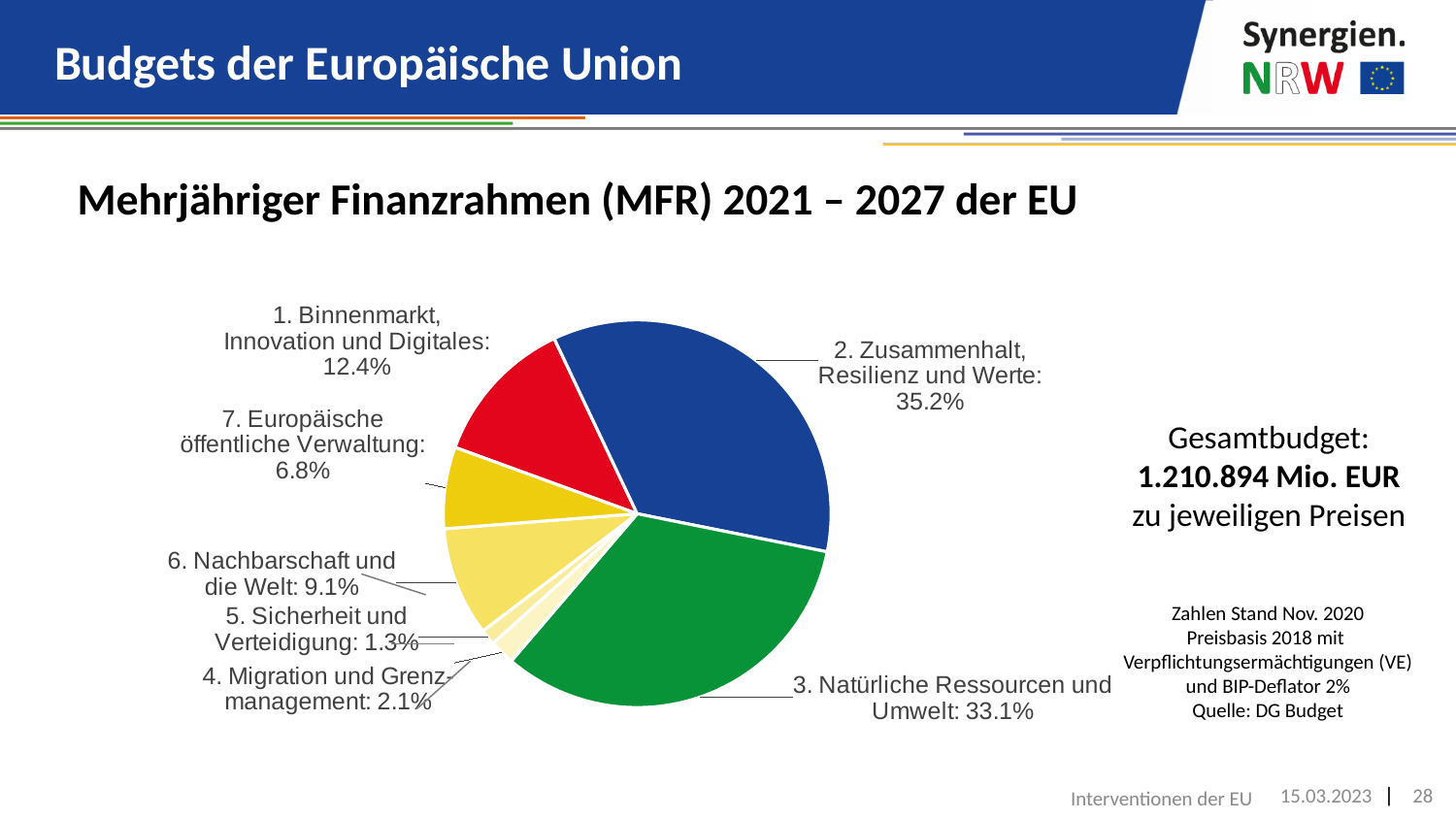
What is the value shown for "1. Binnenmarkt, Innovation und Digitales"? 12.4% How many slices does the pie chart have? 7 Which category has the smallest share of the pie? 5. Sicherheit und Verteidigung Which is larger: "6. Nachbarschaft und die Welt" or "7. Europäische öffentliche Verwaltung"? 6. Nachbarschaft und die Welt What share of the pie is "2. Zusammenhalt, Resilienz und Werte"? 35.2% What is the difference in percentage points between "2. Zusammenhalt, Resilienz und Werte" and "3. Natürliche Ressourcen und Umwelt"? 2.1 percentage points Which category has the largest share of the pie? 2. Zusammenhalt, Resilienz und Werte What is the value shown for "4. Migration und Grenzmanagement"? 2.1% What kind of chart is shown on the slide? Pie chart What is the value shown for "7. Europäische öffentliche Verwaltung"? 6.8% What total budget (Gesamtbudget) is stated next to the pie chart? 1.210.894 Mio. EUR What is the value shown for "3. Natürliche Ressourcen und Umwelt"? 33.1%